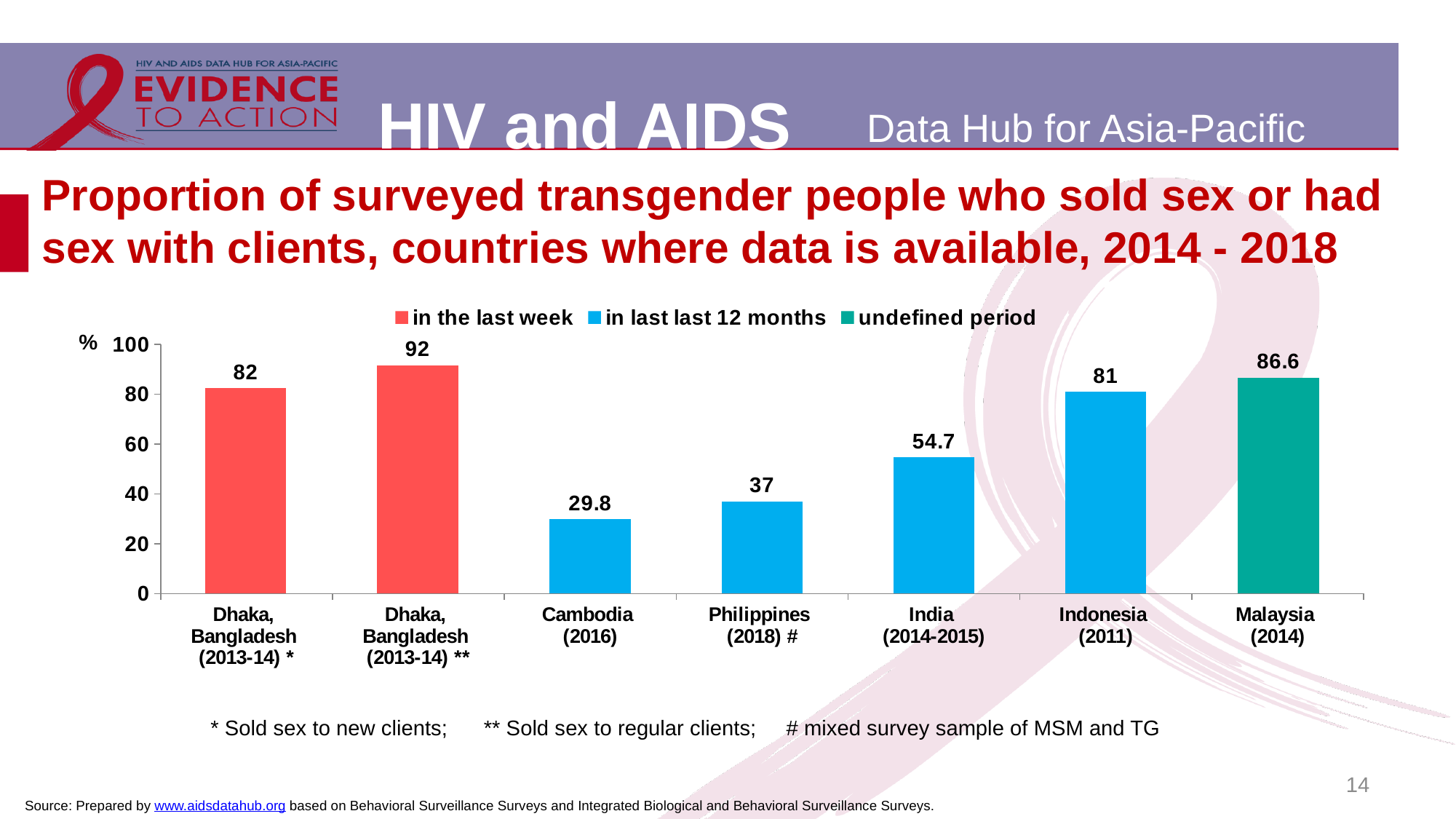
Which legend series does the Malaysia (2014) bar belong to? undefined period What is the value for Malaysia (2014)? 86.6 Is the value for India (2014-2015) greater or less than 60? less What is the value for India (2014-2015)? 54.7 How many series does the legend list? 3 What kind of chart is shown on the slide? bar chart Which category has the lowest value? Cambodia (2016) Which is larger, the value for Malaysia (2014) or the value for Dhaka, Bangladesh (2013-14) *? Malaysia (2014) Which category has the highest value? Dhaka, Bangladesh (2013-14) ** What is the value for Cambodia (2016)? 29.8 What is the difference between the values for Indonesia (2011) and Philippines (2018) #? 44 How many bars are shown in the chart? 7